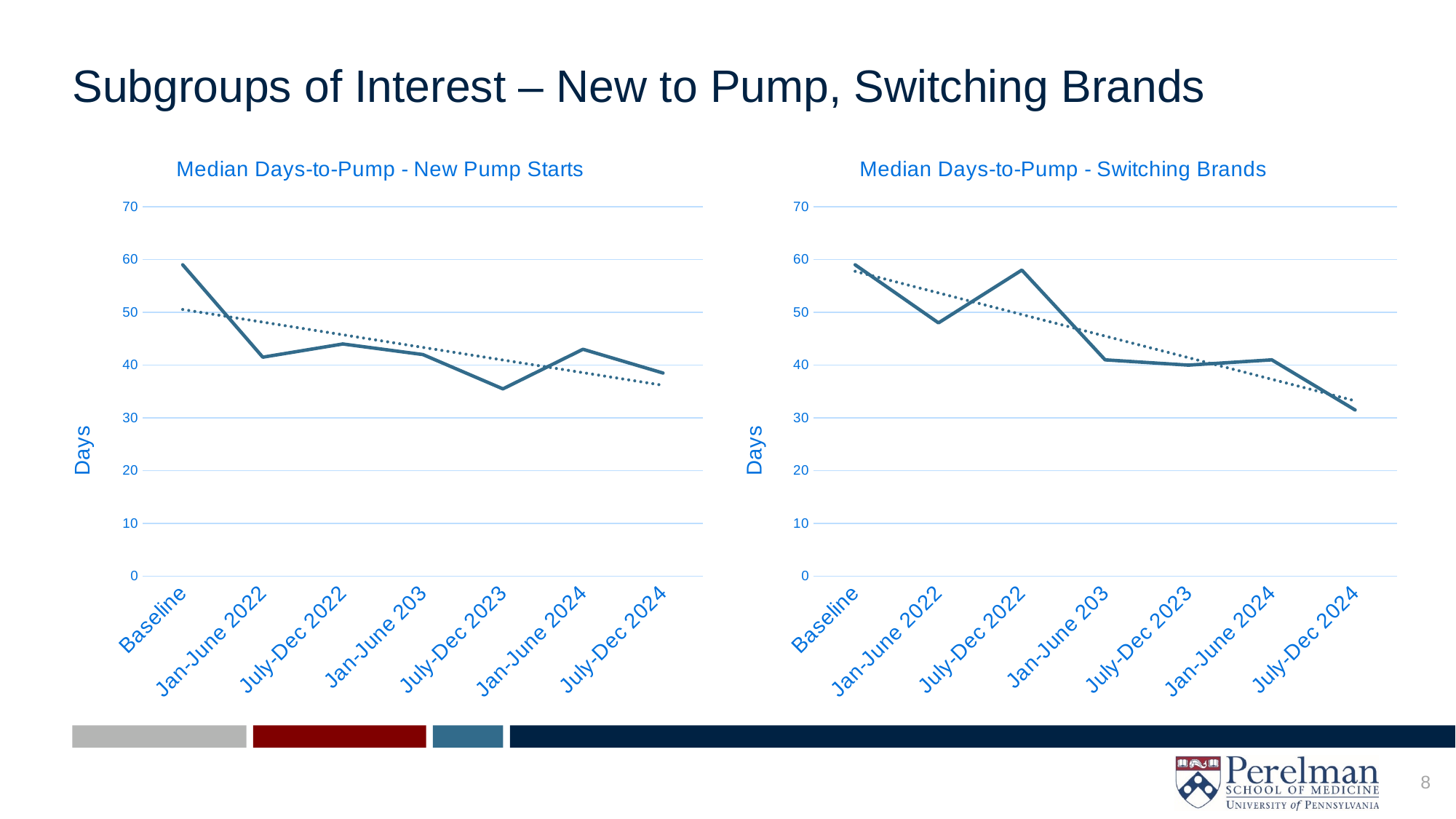
In the "Median Days-to-Pump - New Pump Starts" chart, which period has the lowest median days-to-pump? July-Dec 2023 What kind of chart is the "Median Days-to-Pump - New Pump Starts" chart? line chart What is the y-axis label on the "Median Days-to-Pump - New Pump Starts" chart? Days In the "Median Days-to-Pump - Switching Brands" chart, is the value for July-Dec 2024 greater or less than 40? less How many periods are plotted along the x axis of the "Median Days-to-Pump - Switching Brands" chart? 7 In the "Median Days-to-Pump - New Pump Starts" chart, is the value for July-Dec 2023 greater or less than 40? less In the "Median Days-to-Pump - Switching Brands" chart, which is larger, the value for July-Dec 2022 or the value for Jan-June 2022? July-Dec 2022 In the "Median Days-to-Pump - Switching Brands" chart, which period has the lowest median days-to-pump? July-Dec 2024 In the "Median Days-to-Pump - New Pump Starts" chart, is the value for Baseline greater or less than 50? greater In the "Median Days-to-Pump - Switching Brands" chart, do the values generally rise or fall from Baseline to July-Dec 2024? fall In the "Median Days-to-Pump - New Pump Starts" chart, which period has the highest median days-to-pump? Baseline